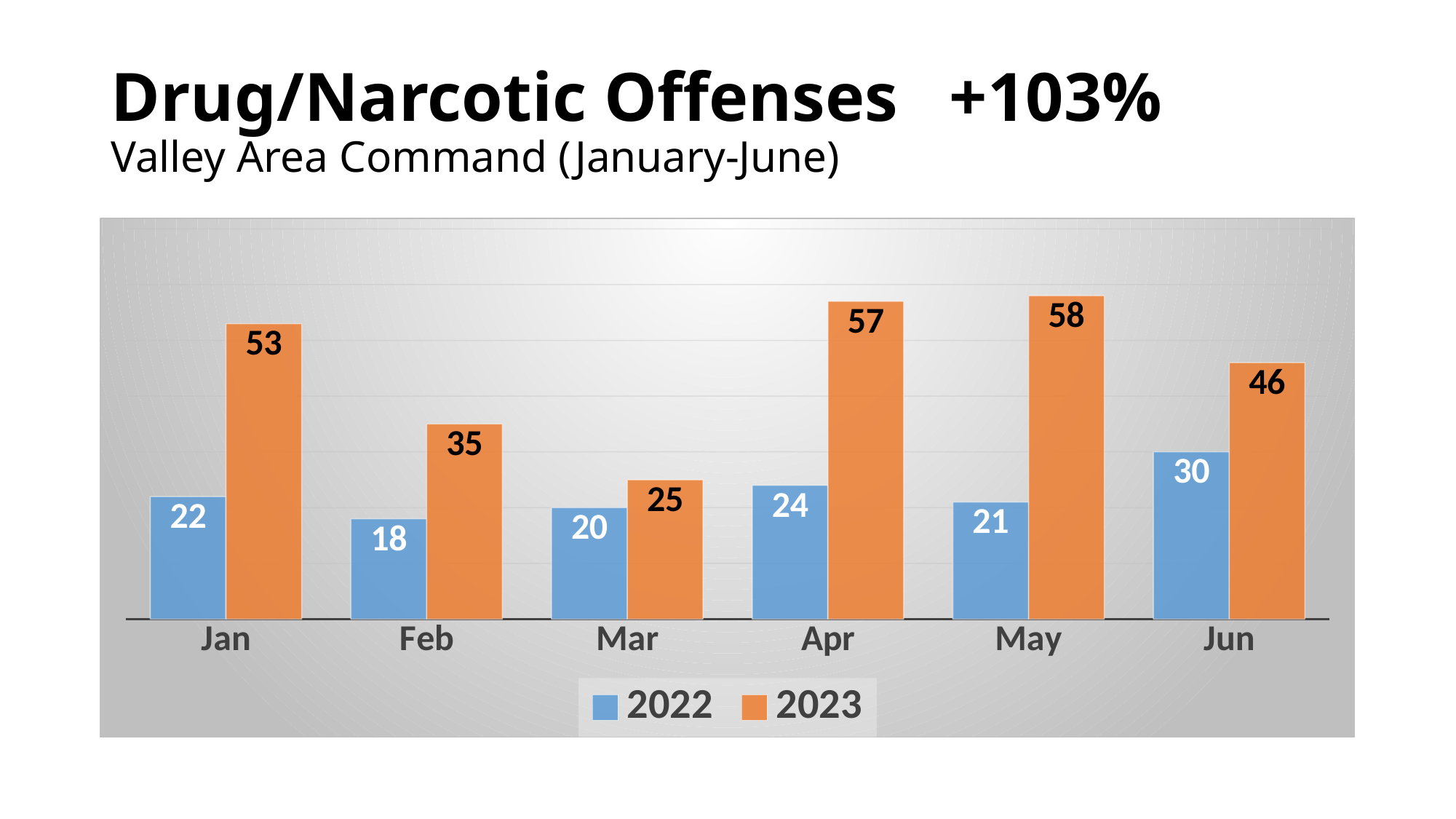
What is the difference between the 2023 and 2022 values in January? 31 What is the difference between the 2023 values in May and June? 12 How many series does the legend list? 2 What percentage change is shown in the chart title? +103% What is the value for 2022 in February? 18 What kind of chart is shown on the slide? Bar chart Which month has the lowest value for 2023? Mar Which month has the highest value for 2023? May What is the value for 2023 in April? 57 Which is larger, the 2022 value in June or the 2022 value in April? 2022 value in June How many months are shown on the x axis? 6 Which month has the lowest value for 2022? Feb